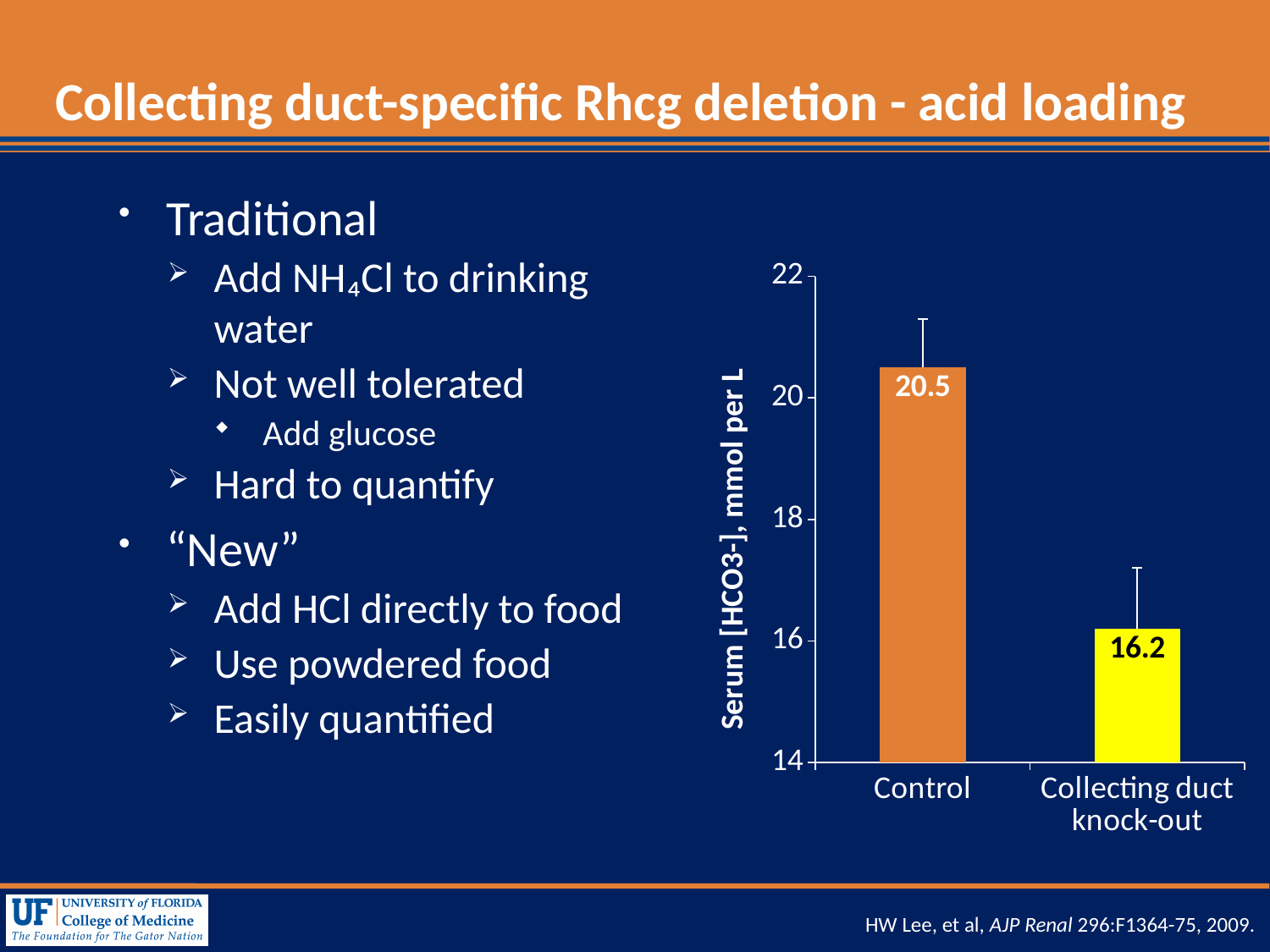
Is the value for Control greater or less than 20? greater Which group has the higher serum [HCO3-]? Control What is the serum [HCO3-] value for the Control group? 20.5 Which group has the lower serum [HCO3-]? Collecting duct knock-out How many groups are plotted in the chart? 2 What is the serum [HCO3-] value for the Collecting duct knock-out group? 16.2 What is the difference in serum [HCO3-] between the Control and Collecting duct knock-out groups? 4.3 Is the serum [HCO3-] for Control greater or less than that for Collecting duct knock-out? greater What colour is the bar for the Collecting duct knock-out group? Yellow What is the label of the y axis of the chart? Serum [HCO3-], mmol per L What kind of chart is shown on the slide? Bar chart Is the value for Collecting duct knock-out greater or less than 18? less